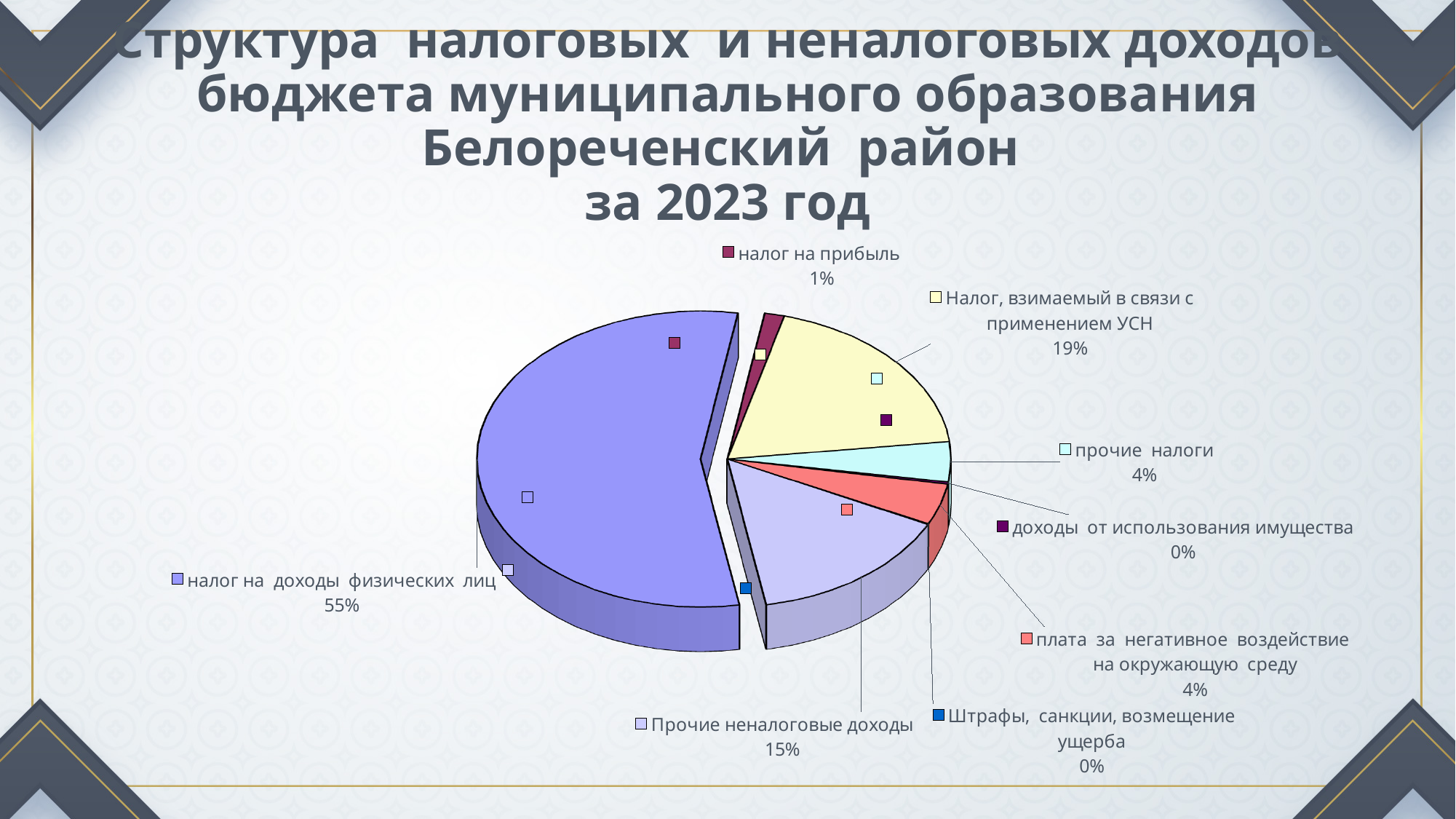
By how many percentage points does the share for налог на доходы физических лиц exceed the share for Налог, взимаемый в связи с применением УСН? 36 percentage points Which category has the largest share of the pie? налог на доходы физических лиц What share is shown for плата за негативное воздействие на окружающую среду? 4% What kind of chart is shown on the slide? pie chart Which is larger: the share for Налог, взимаемый в связи с применением УСН or the share for Прочие неналоговые доходы? Налог, взимаемый в связи с применением УСН Which year does the chart title say the data is for? 2023 What share is shown for налог на прибыль? 1% How many categories does the pie chart show? 8 What share is shown for Прочие неналоговые доходы? 15%